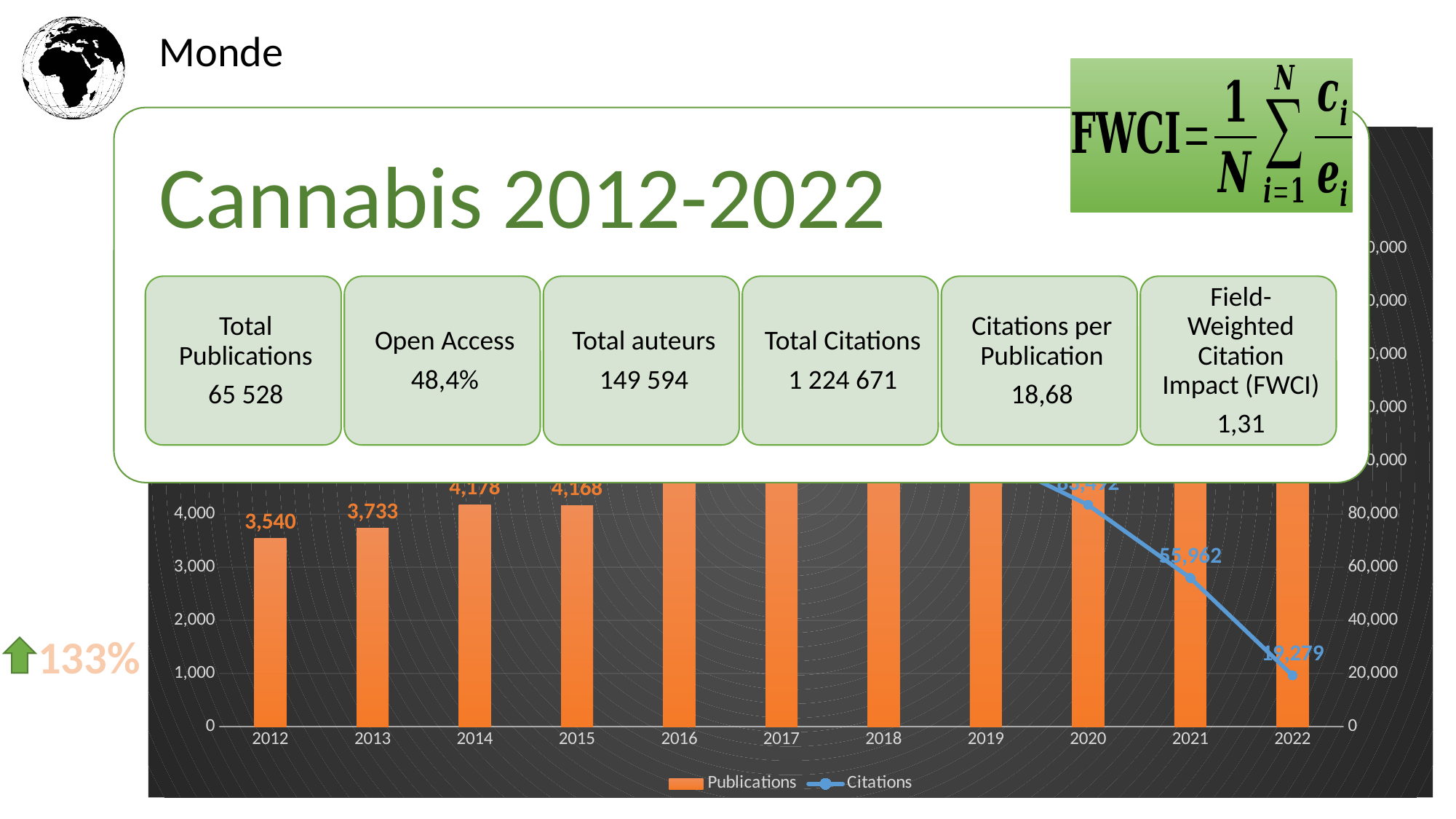
What is the difference in Citations between 2021 and 2022? 36,683 What is the number of Publications for 2014? 4,178 How many series does the chart legend list? 2 What is the number of Publications for 2013? 3,733 Do Citations rise or fall from 2020 to 2022? fall How many years are shown on the x axis of the chart? 11 What is the number of Publications for 2015? 4,168 What is the number of Citations for 2022? 19,279 By how much did Publications increase from 2012 to 2013? 193 What is the number of Publications for 2012? 3,540 What is the number of Citations for 2021? 55,962 Which year has more Publications, 2014 or 2015? 2014